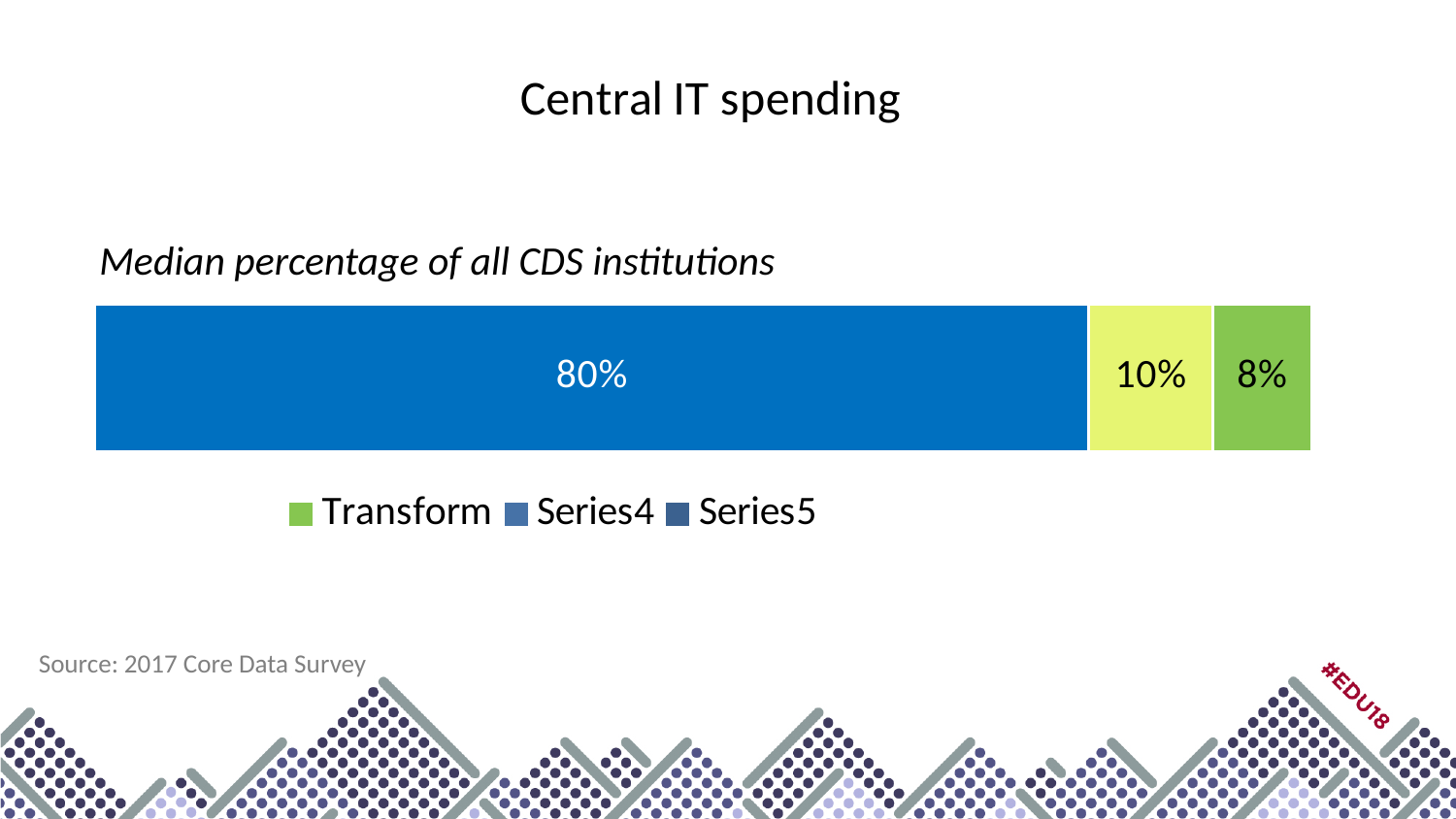
What is the difference between the largest segment (80%) and the middle segment (10%)? 70% How many segments make up the stacked bar? 3 What is the value printed on the largest (blue) segment of the bar? 80% What is the title of the chart? Central IT spending What kind of chart is shown on the slide? bar chart Which segment of the bar has the lowest value? the green segment (8%) What is the value printed on the rightmost (green) segment of the bar? 8% What is the difference between the 10% segment and the 8% segment? 2% Which segment of the bar has the highest value? the blue segment (80%) What is the value printed on the middle (yellow-green) segment of the bar? 10% Which is larger, the middle segment or the rightmost segment of the bar? the middle segment (10%) How many entries does the legend list? 3